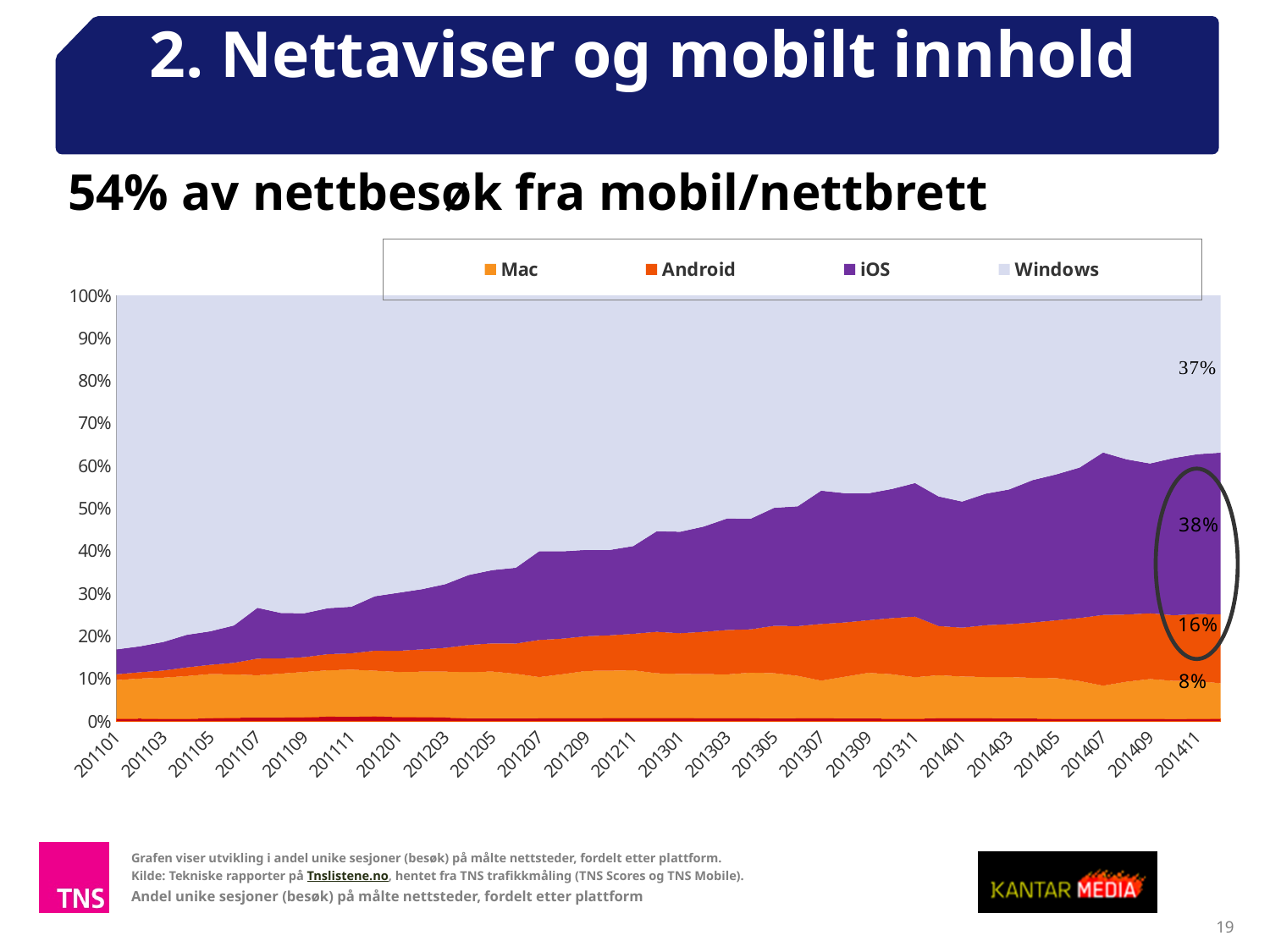
At the end of the series, which is larger: the Android share or the Mac share? Android What share does Windows have at the end of the series, according to the data label? 37% Is the Windows share at 201101 greater or less than 70%? greater Which series has the smallest share at the end of the series, based on the data labels? Mac Does the iOS share rise or fall from 201101 to 201411? Rises What is the combined share of iOS and Android at the end of the series, using the data labels? 54% How many series does the legend list? 4 What kind of chart is shown on the slide? Stacked area chart What is the difference between the iOS share (38%) and the Android share (16%) at the end of the series? 22 percentage points What share does iOS have at the end of the series, according to the data label? 38% What share does Android have at the end of the series, according to the data label? 16% What share does Mac have at the end of the series, according to the data label? 8%